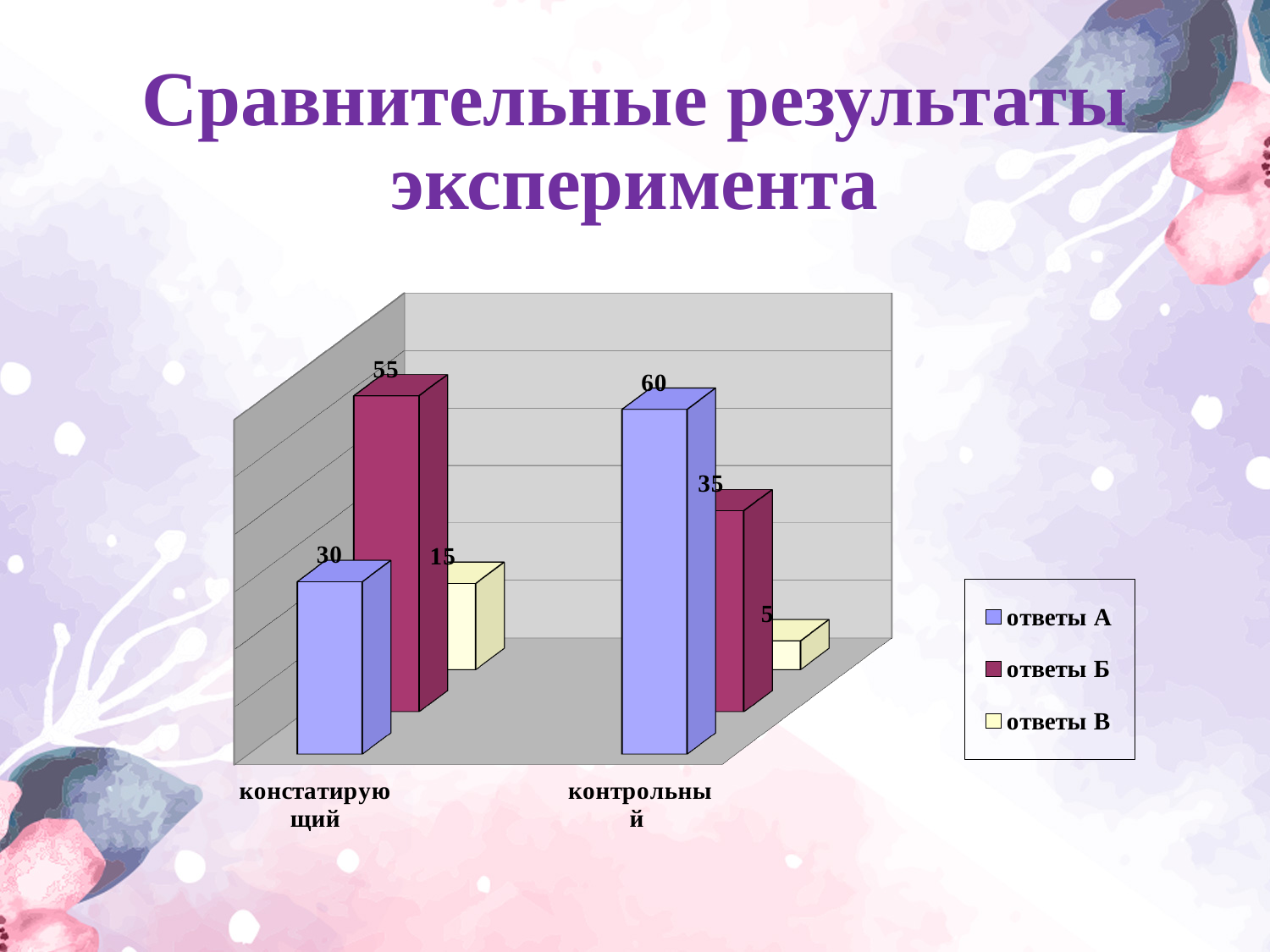
How many series does the legend list? 3 Which series has the lowest value in the констатирующий category? ответы В How many categories are shown on the x axis? 2 What is the title of the slide? Сравнительные результаты эксперимента What kind of chart is shown on the slide? bar chart What is the value of ответы А for the констатирующий category? 30 What is the value of ответы Б for the констатирующий category? 55 What is the difference between ответы А in the контрольный category and ответы А in the констатирующий category? 30 Which series has the highest value in the контрольный category? ответы А What is the value of ответы А for the контрольный category? 60 Which is larger: ответы Б in the констатирующий category or ответы Б in the контрольный category? констатирующий What is the value of ответы В for the контрольный category? 5